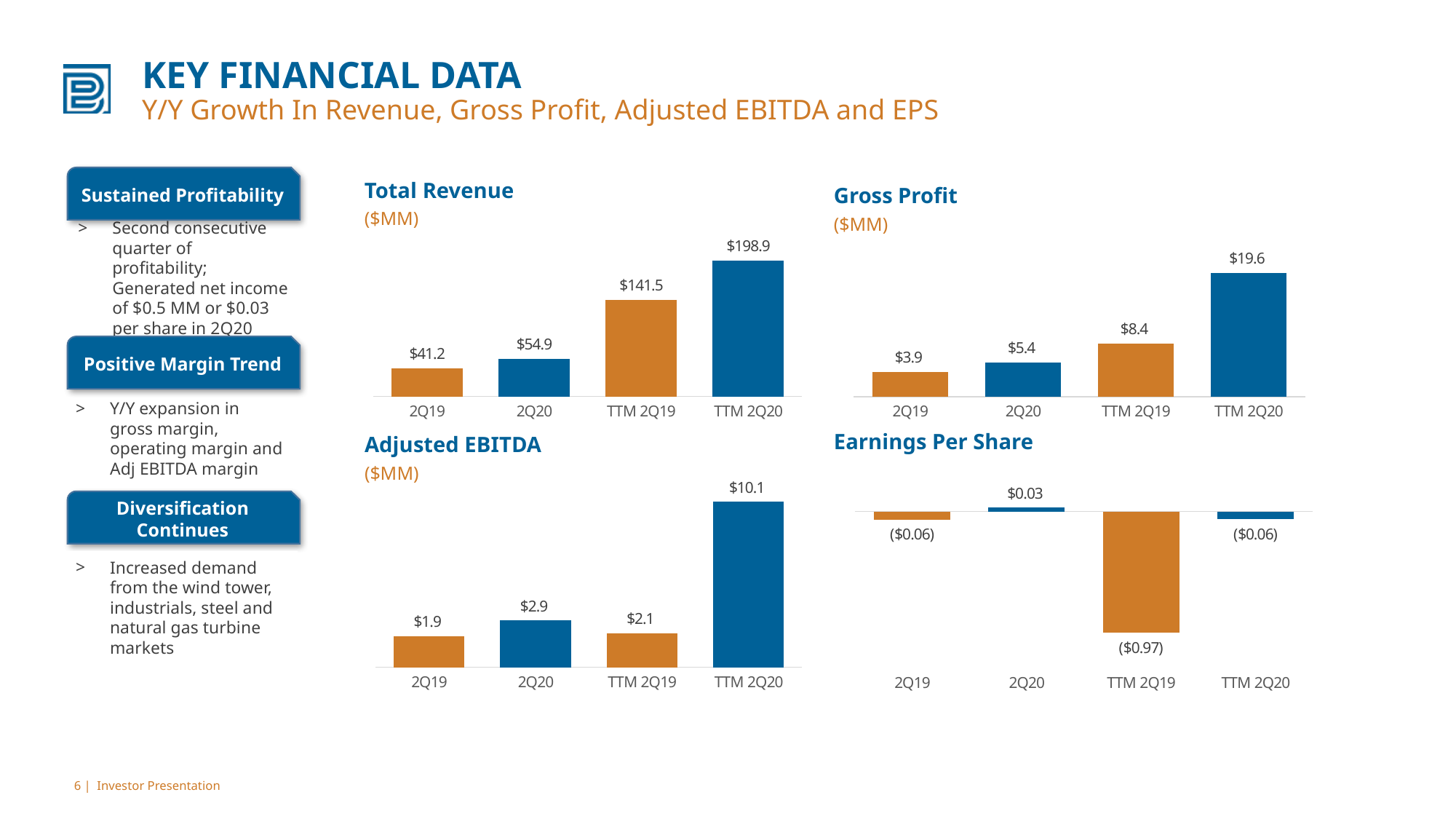
In the Total Revenue chart, what is the difference between 2Q20 and 2Q19? $13.7 In the Total Revenue chart, what is the value for 2Q19? $41.2 In the Earnings Per Share chart, what is the value for TTM 2Q19? ($0.97) In the Total Revenue chart, which is larger, 2Q20 or TTM 2Q19? TTM 2Q19 In the Gross Profit chart, which category has the highest value? TTM 2Q20 In the Earnings Per Share chart, which category has the highest value? 2Q20 In the Adjusted EBITDA chart, what is the value for 2Q20? $2.9 What kind of chart is the Adjusted EBITDA chart? Bar chart In the Total Revenue chart, what is the value for TTM 2Q20? $198.9 In the Gross Profit chart, what is the difference between TTM 2Q20 and TTM 2Q19? $11.2 How many categories does the Gross Profit chart show? 4 In the Adjusted EBITDA chart, which category has the lowest value? 2Q19